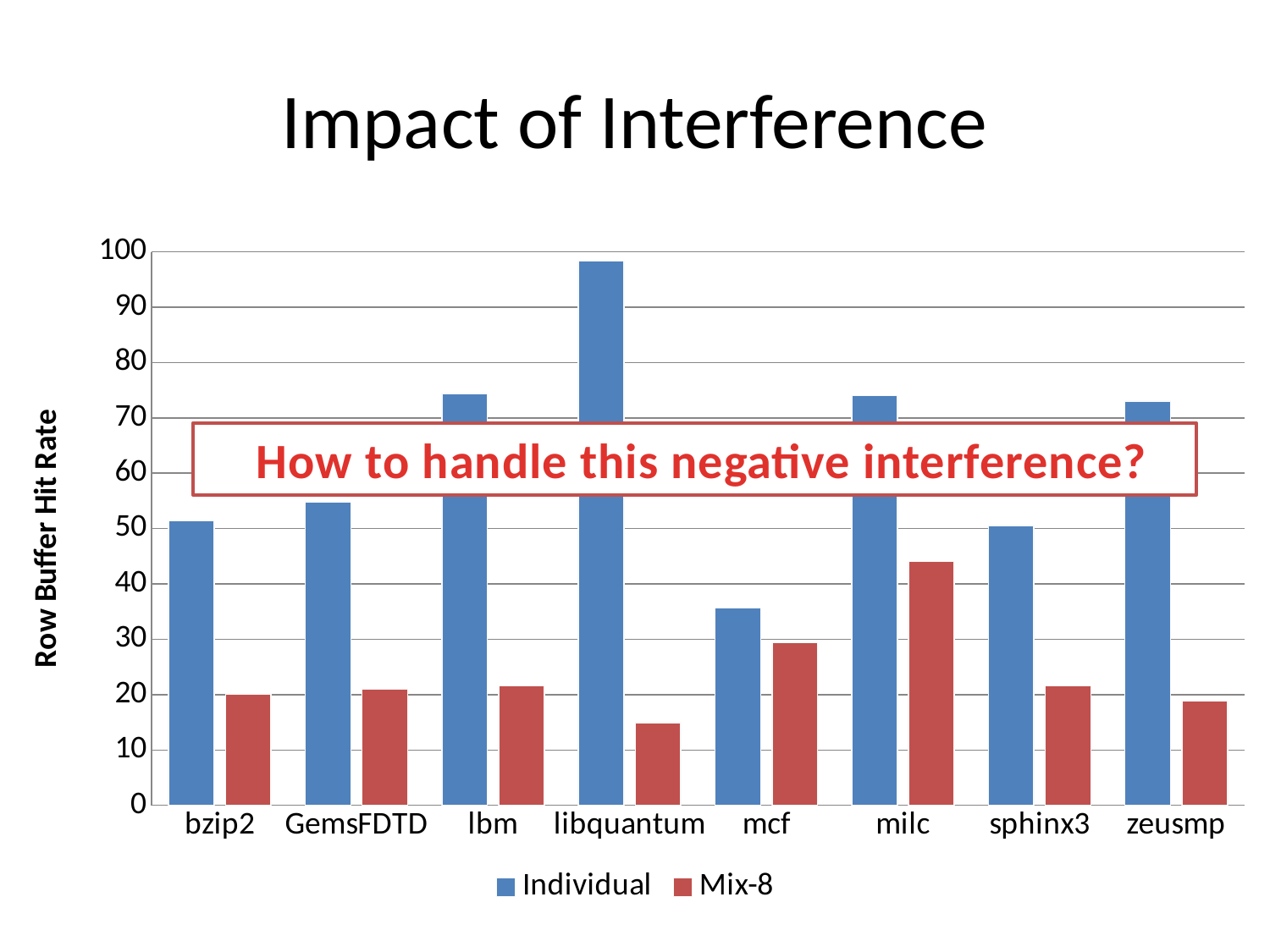
Which category has the highest Individual row buffer hit rate? libquantum How many series does the legend list? 2 Which category has the lowest Individual row buffer hit rate? mcf For milc, which series has the larger value, Individual or Mix-8? Individual Is the Mix-8 value for milc greater or less than 40? greater Is the Individual value for mcf greater or less than 40? less Is the Individual value for libquantum greater or less than 90? greater What kind of chart is shown on the slide? bar chart Which category has the highest Mix-8 row buffer hit rate? milc How many benchmark categories are shown on the x axis? 8 What is the label of the y axis? Row Buffer Hit Rate